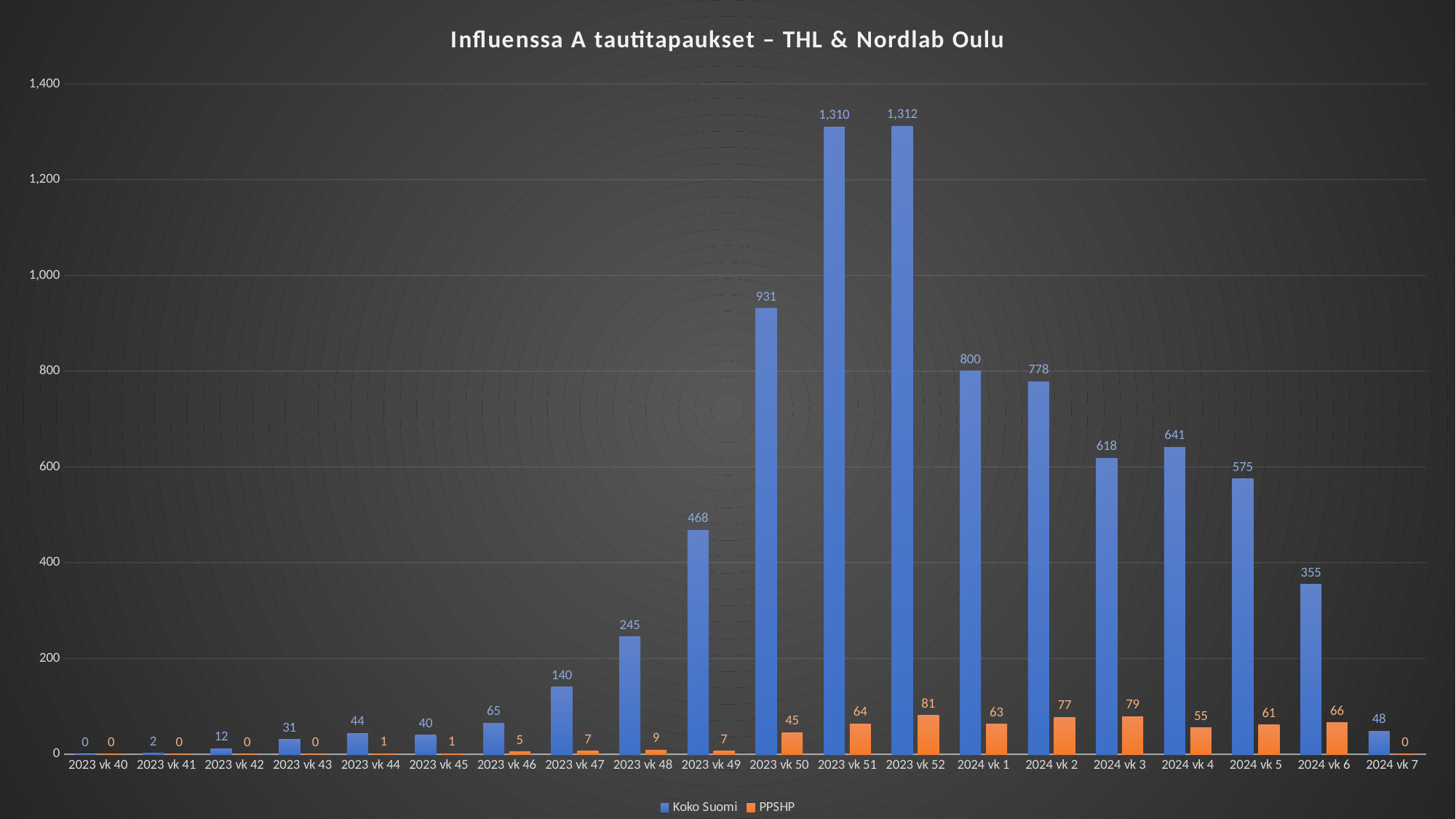
Which is larger, the Koko Suomi value for 2024 vk 3 or for 2024 vk 4? 2024 vk 4 Which week has the highest PPSHP value? 2023 vk 52 What kind of chart is shown on the slide? bar chart What is the Koko Suomi value for 2023 vk 50? 931 What is the difference between the Koko Suomi and PPSHP values for 2023 vk 52? 1,231 How many weeks are shown on the x axis? 20 How many series does the legend list? 2 Do the Koko Suomi values rise or fall from 2023 vk 52 to 2024 vk 7? fall What is the PPSHP value for 2024 vk 2? 77 What is the difference between the Koko Suomi values for 2024 vk 1 and 2024 vk 2? 22 What is the Koko Suomi value for 2024 vk 6? 355 Is the Koko Suomi value for 2023 vk 49 greater or less than 400? greater